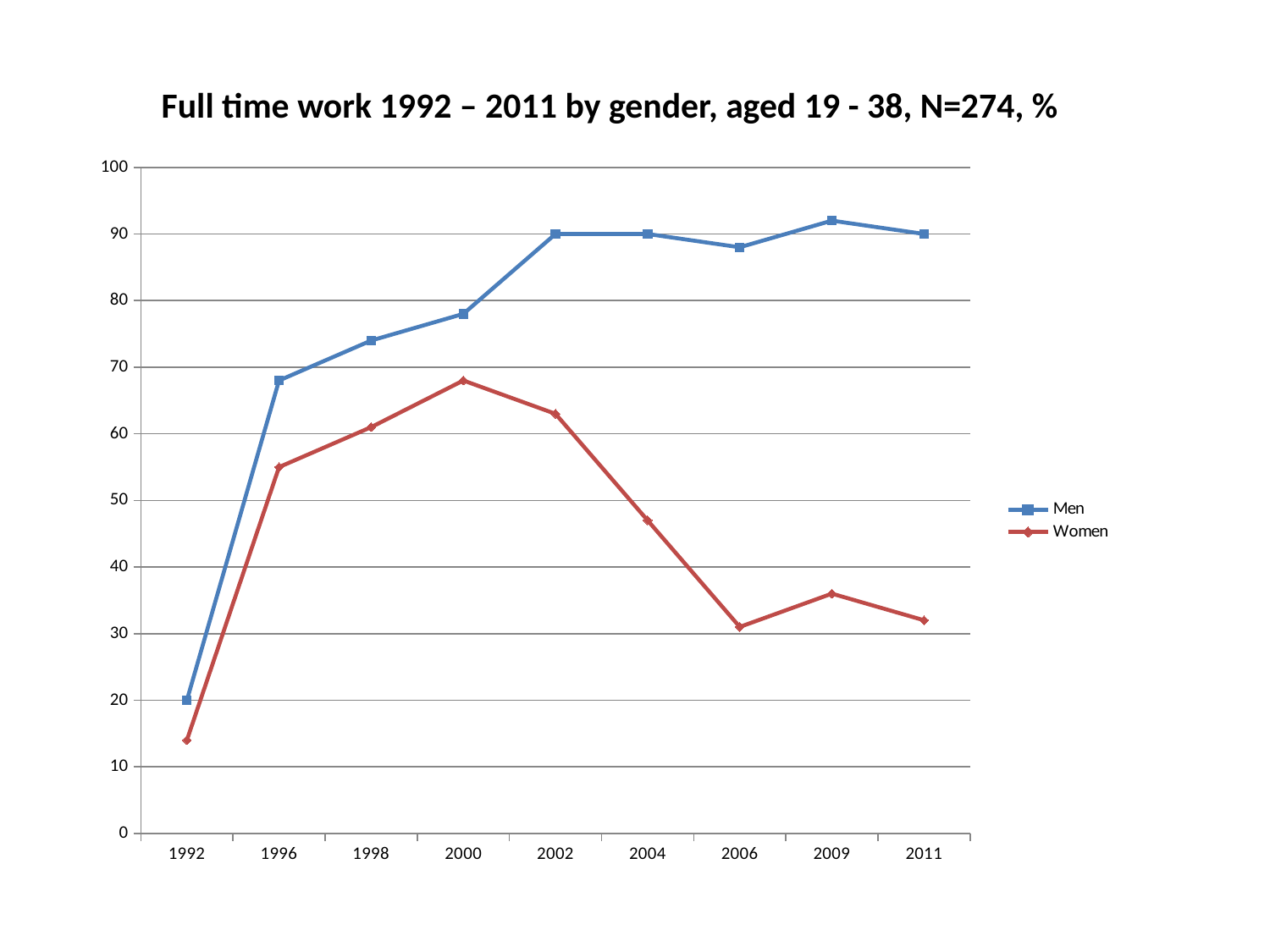
How many years are plotted along the x axis? 9 In which year is the value for Women lowest? 1992 What kind of chart is shown on the slide? line chart Which colour is used for the Women series? red In which year is the value for Men lowest? 1992 Do the values for Women rise or fall from 2002 to 2006? fall Is the value for Women in 2004 greater or less than 50? less In which year is the value for Men highest? 2009 In which year is the value for Women highest? 2000 Is the value for Men in 2000 greater or less than 70? greater How many series does the legend list? 2 Which series has the larger value in 2006, Men or Women? Men